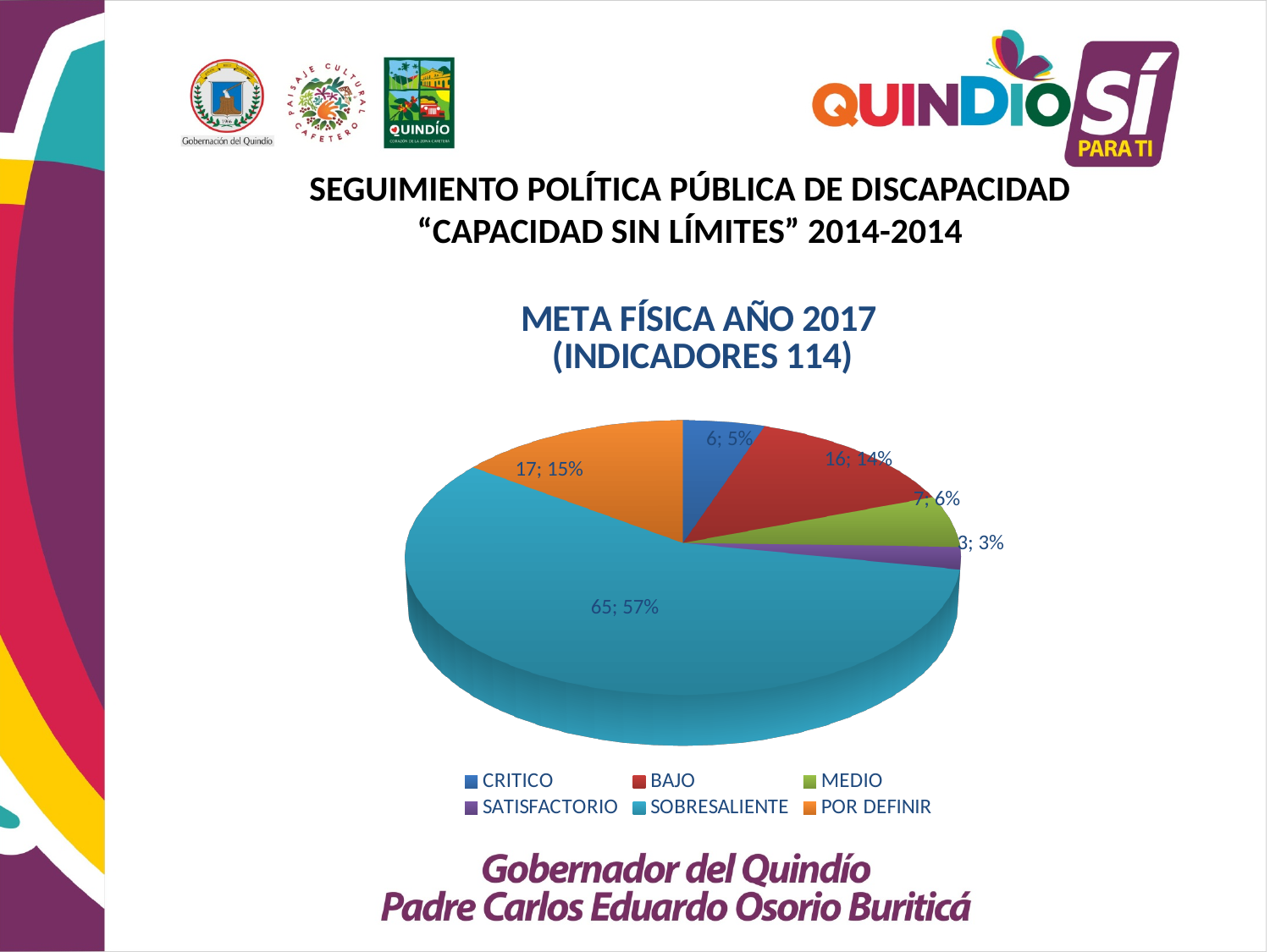
What is the value shown for SOBRESALIENTE? 65 What percentage share does SOBRESALIENTE have in the pie chart? 57% What percentage share does POR DEFINIR have in the pie chart? 15% What is the value shown for BAJO? 16 What kind of chart is shown on the slide? pie chart Which category has the smallest slice of the pie chart? SATISFACTORIO What is the value shown for CRITICO? 6 Which is larger, the value for MEDIO or the value for SATISFACTORIO? MEDIO What is the title of the chart? META FÍSICA AÑO 2017 (INDICADORES 114) Which category has the largest slice of the pie chart? SOBRESALIENTE What is the difference between the values for POR DEFINIR and BAJO? 1 How many categories does the legend of the pie chart list? 6